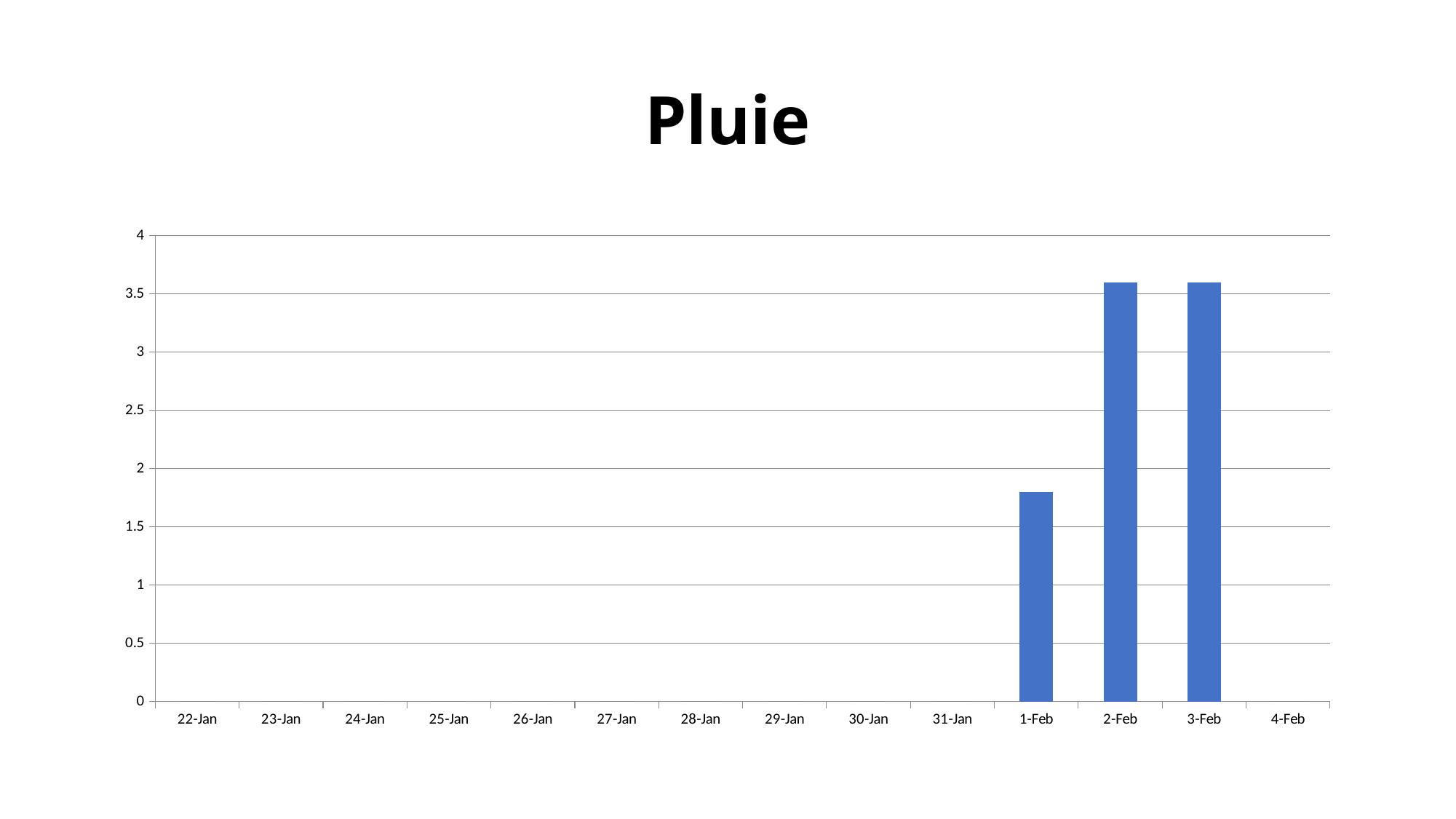
What is the first date shown on the x axis? 22-Jan What kind of chart is shown on the slide? bar chart Do the values rise or fall from 1-Feb to 2-Feb? rise Is the value for 3-Feb greater or less than 4? less Is the value for 1-Feb greater or less than 1.5? greater Is the value for 2-Feb greater or less than 3.5? greater How many dates show a visible bar in the chart? 3 Which has the larger value, 3-Feb or 1-Feb? 3-Feb How many dates are listed along the x axis of the chart? 14 Which has the larger value, 1-Feb or 2-Feb? 2-Feb What is the title of the chart? Pluie